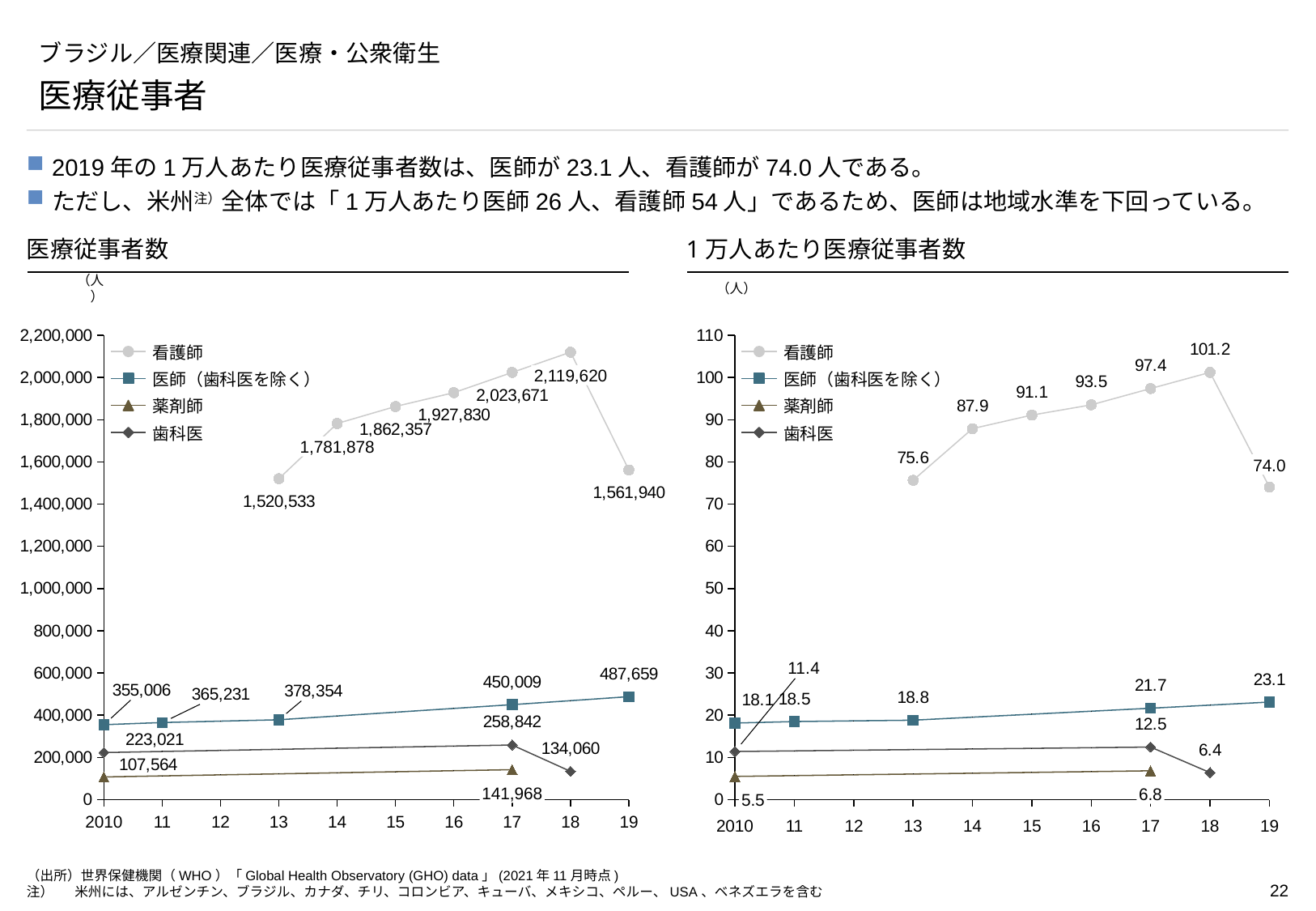
In the 1万人あたり医療従事者数 chart on the right, what is the value for 看護師 in 2019? 74.0 In the 医療従事者数 chart on the left, how many series does the legend list? 4 In the 1万人あたり医療従事者数 chart on the right, which series has the lowest value in 2010? 薬剤師 In the 1万人あたり医療従事者数 chart on the right, what is the value for 歯科医 in 2018? 6.4 In the 1万人あたり医療従事者数 chart on the right, is the value for 医師（歯科医を除く） in 2019 greater or less than 20? greater In the 医療従事者数 chart on the left, what is the value for 医師（歯科医を除く） in 2019? 487,659 In the 医療従事者数 chart on the left, what is the difference between the 看護師 values for 2018 and 2019? 557,680 In the 医療従事者数 chart on the left, what is the value for 看護師 in 2018? 2,119,620 What kind of chart is the 1万人あたり医療従事者数 chart on the right? Line chart In the 1万人あたり医療従事者数 chart on the right, does the 医師（歯科医を除く） series rise or fall from 2010 to 2019? Rise In the 医療従事者数 chart on the left, in which year does the 看護師 series reach its highest value? 2018 In the 医療従事者数 chart on the left, what is the value for 薬剤師 in 2010? 107,564